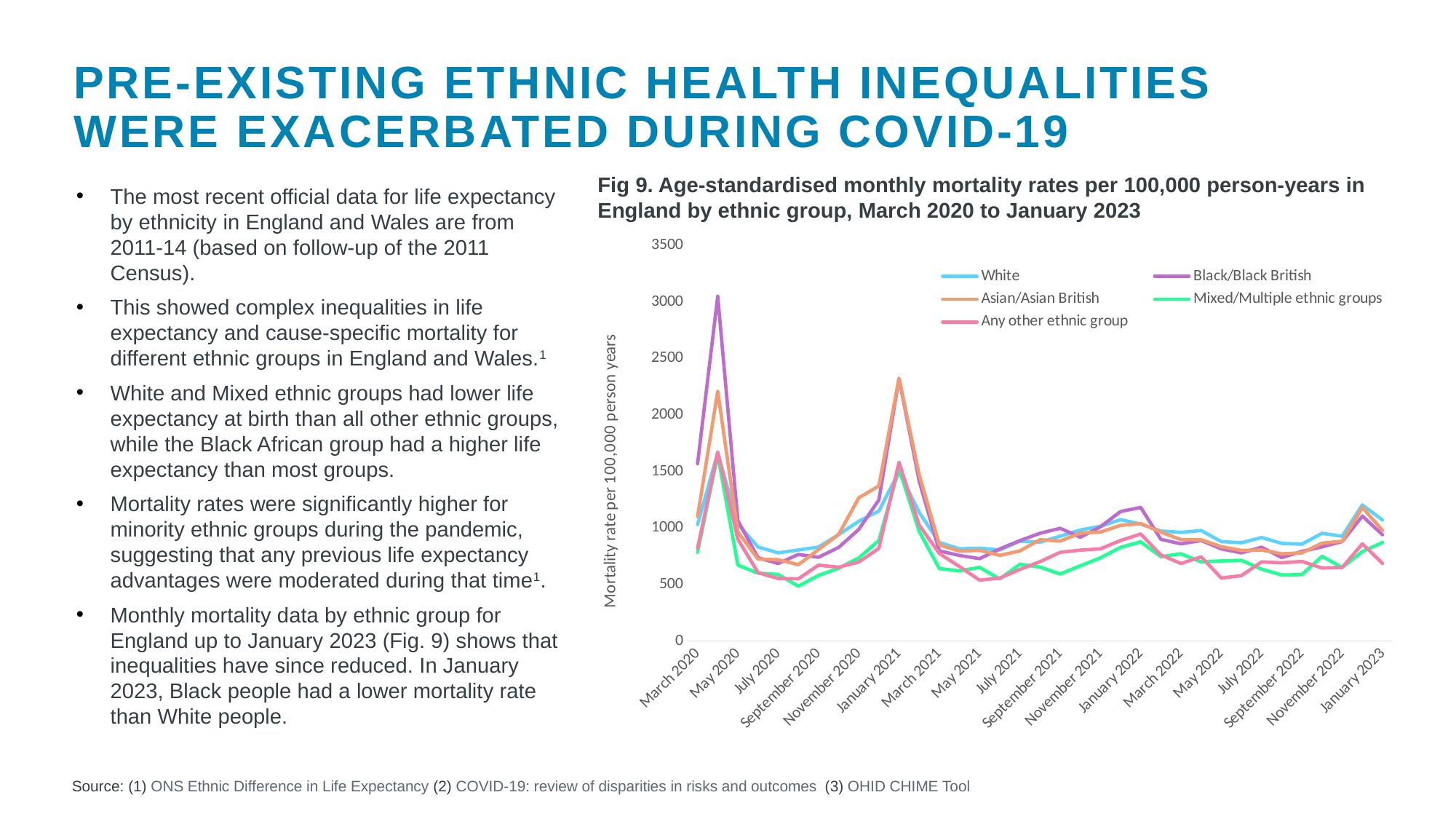
How many series does the legend of Fig 9 list? 5 Which ethnic group has the lowest mortality rate in September 2020? Mixed/Multiple ethnic groups Do the mortality rates rise or fall between January 2021 and March 2021? fall Is the value for Asian/Asian British at its January 2021 peak greater or less than 2000? greater Is the value for Mixed/Multiple ethnic groups in September 2020 greater or less than 1000? less What is the label of the y axis? Mortality rate per 100,000 person years Which ethnic group has the highest peak mortality rate in the chart? Black/Black British In January 2023, which is higher: White or Black/Black British? White How many month labels are shown on the x axis? 18 What type of chart is shown in Fig 9? line chart Is the peak value for Black/Black British in spring 2020 greater or less than 2500? greater At the spring 2020 peak, which is higher: Black/Black British or Asian/Asian British? Black/Black British